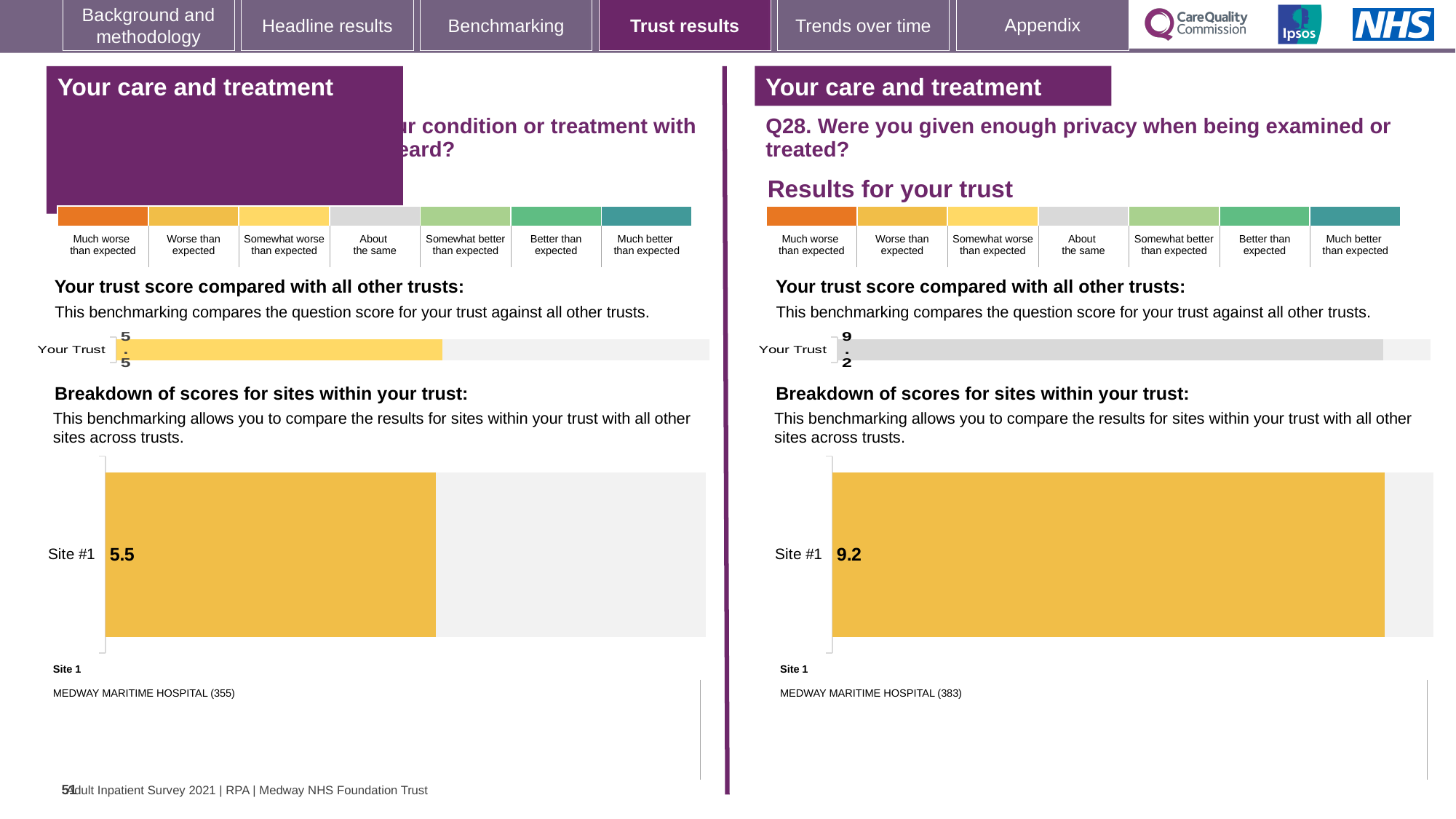
How many sites are shown in the 'Breakdown of scores for sites within your trust' chart on the left half of the slide? 1 Which site score is larger: Site #1 on the left chart or Site #1 on the right chart (Q28)? Site #1 on the right chart (Q28) On the left half of the slide, what value is shown for 'Your Trust' in the trust score comparison bar? 5.5 What kind of chart is used to show the breakdown of scores for sites within the trust on each half of the slide? Bar chart On the left half of the slide, what is the trust score shown for Site #1? 5.5 What is the difference between the Site #1 score on the right chart (Q28) and the Site #1 score on the left chart? 3.7 How many sites are shown in the 'Breakdown of scores for sites within your trust' chart on the right half of the slide? 1 On the right half of the slide (Q28), which site is listed as Site 1 below the chart? MEDWAY MARITIME HOSPITAL (383) On the left half of the slide, which site is listed as Site 1 below the chart? MEDWAY MARITIME HOSPITAL (355) On the right half of the slide (Q28, privacy when being examined or treated), what is the score shown for Site #1? 9.2 On the right half of the slide (Q28), what value is shown for 'Your Trust' in the trust score comparison bar? 9.2